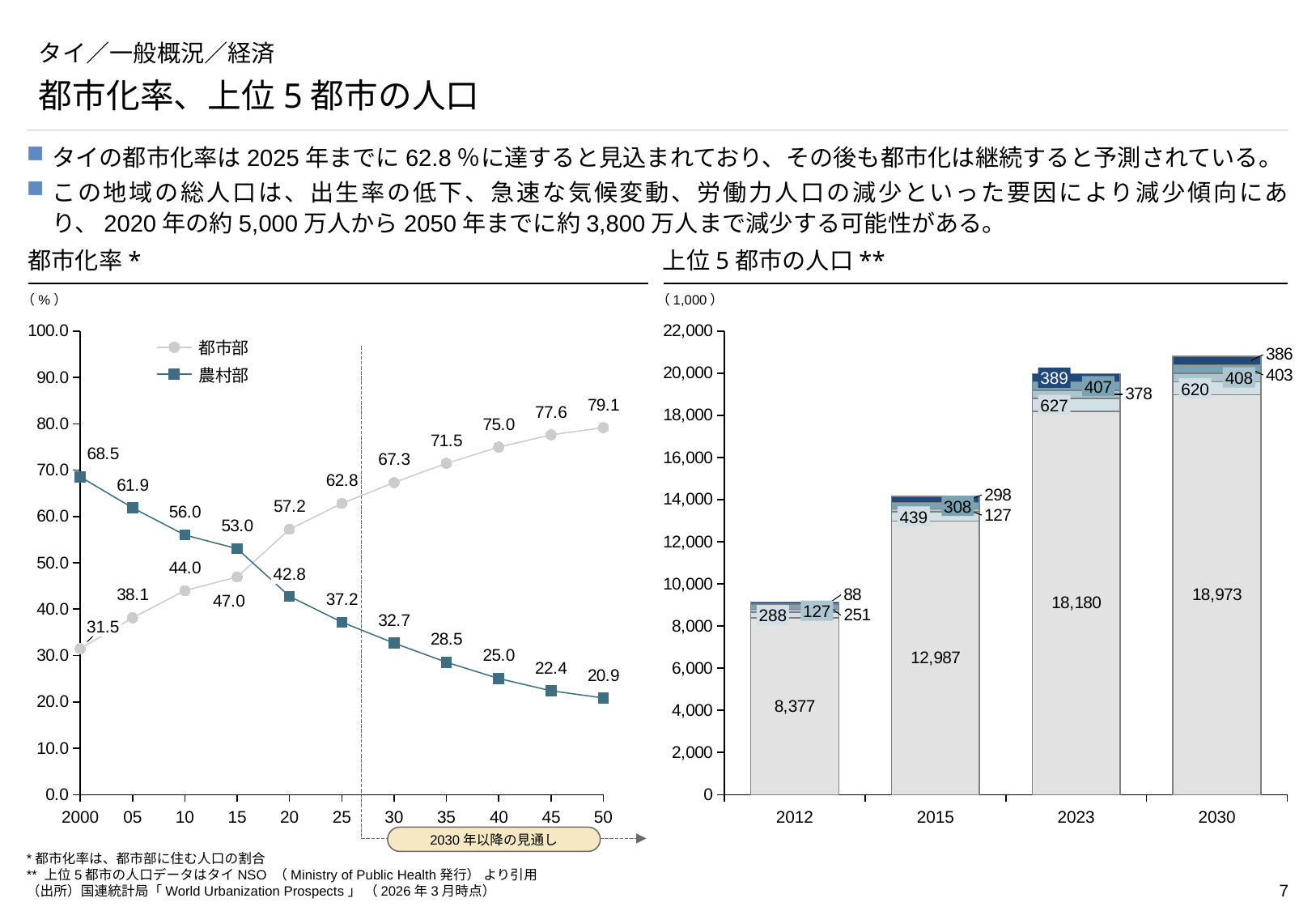
In the 都市化率 chart on the left, what is the value for 農村部 in 2000? 68.5 In the 都市化率 chart on the left, what is the difference between the 都市部 values for 2050 and 2000? 47.6 In the 都市化率 chart on the left, how many series does the legend list? 2 In the 上位5都市の人口 chart on the right, which year has the lowest total? 2012 In the 都市化率 chart on the left, does the 農村部 series rise or fall from 2000 to 2050? fall What kind of chart is the 上位5都市の人口 chart on the right? stacked bar chart In the 都市化率 chart on the left, which is larger in 2015: 都市部 or 農村部? 農村部 In the 都市化率 chart on the left, what is the value for 都市部 in 2025? 62.8 In the 都市化率 chart on the left, how many years are plotted on the x axis? 11 In the 上位5都市の人口 chart on the right, is the total for 2023 greater or less than 18,000? greater In the 上位5都市の人口 chart on the right, what is the difference between the largest segments for 2030 and 2023? 793 In the 上位5都市の人口 chart on the right, what is the value of the largest segment for 2015? 12,987